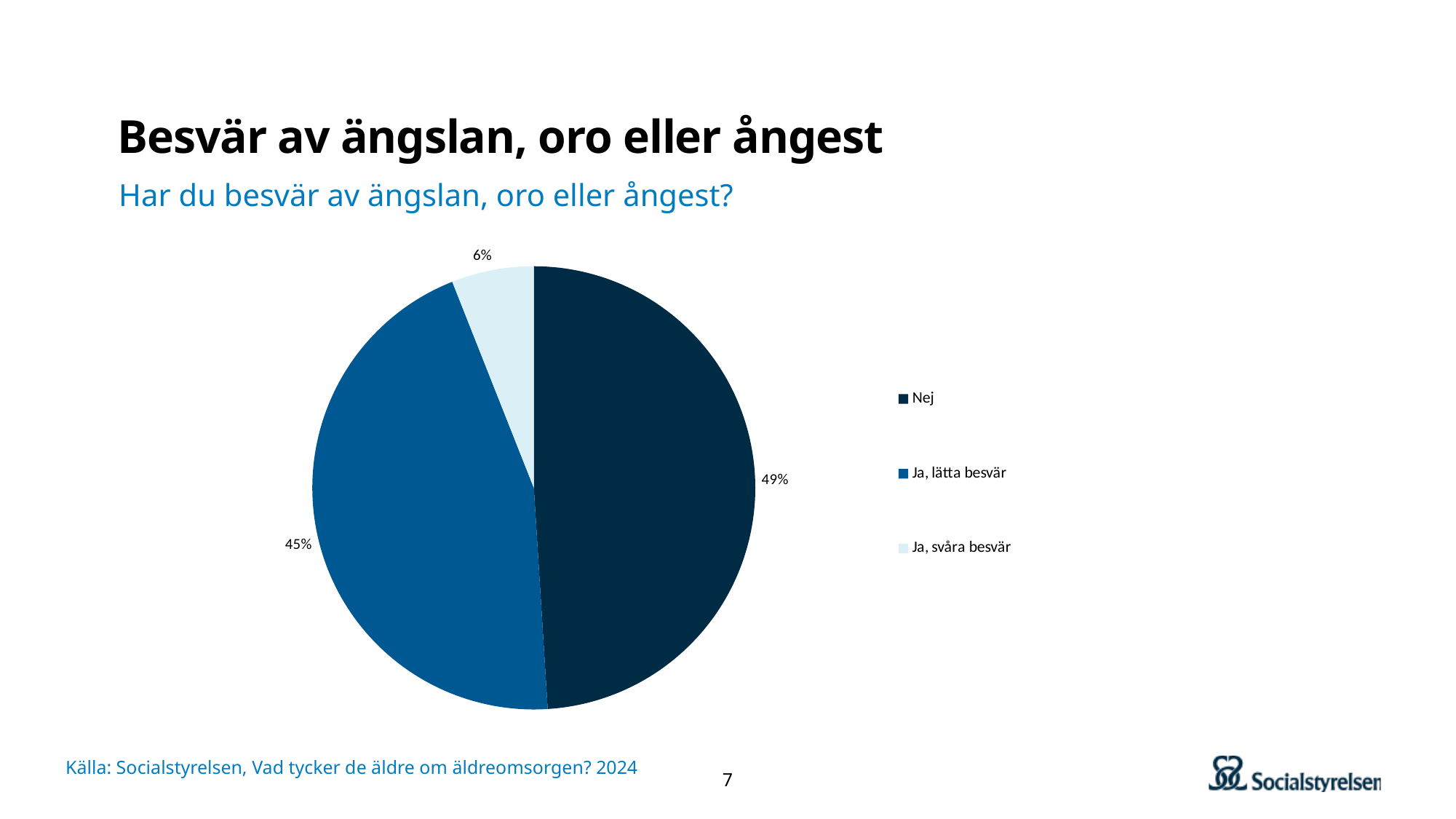
What share of the pie is labelled "Nej"? 49% How many categories does the pie chart have? 3 Which is larger, the slice for "Ja, lätta besvär" or the slice for "Ja, svåra besvär"? Ja, lätta besvär What is the difference in percentage points between "Nej" and "Ja, lätta besvär"? 4 What question is shown as the chart's subtitle? Har du besvär av ängslan, oro eller ångest? What is the difference in percentage points between "Ja, lätta besvär" and "Ja, svåra besvär"? 39 What share of the pie is labelled "Ja, lätta besvär"? 45% What kind of chart is shown on the slide? pie chart How many entries does the legend list? 3 Which category has the largest slice of the pie? Nej What share of the pie is labelled "Ja, svåra besvär"? 6% Which category has the smallest slice of the pie? Ja, svåra besvär